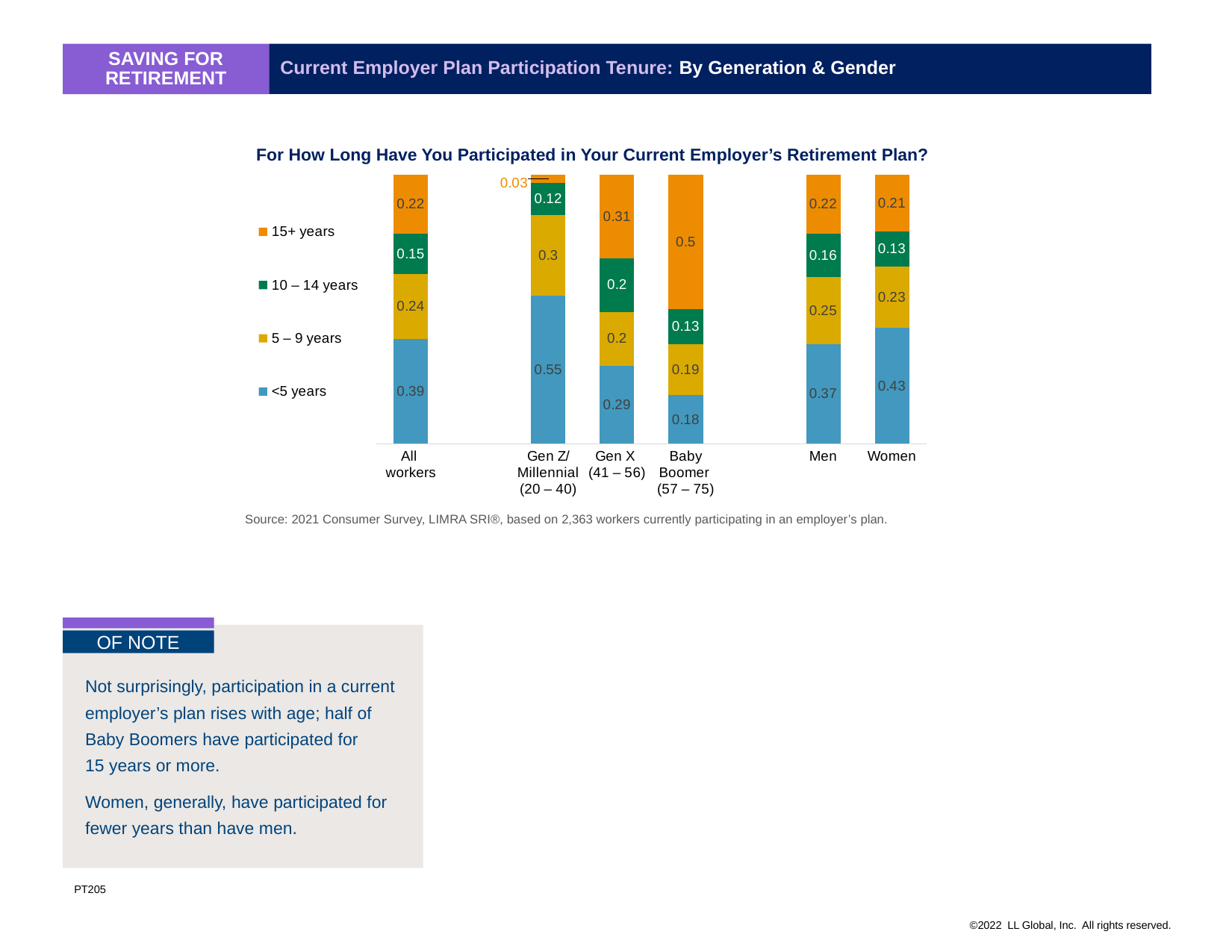
How many categories are plotted along the x axis? 6 What is the value for 15+ years for Baby Boomer (57 – 75)? 0.5 What kind of chart is shown on the slide? Stacked bar chart What is the difference between the <5 years values for Women and Men? 0.06 What is the value for 10 – 14 years for Men? 0.16 Which is larger, the 15+ years value for Gen X (41 – 56) or for All workers? Gen X (41 – 56) Which category has the highest value for 15+ years? Baby Boomer (57 – 75) Which category has the lowest value for <5 years? Baby Boomer (57 – 75) How many series does the legend list? 4 What is the value for 5 – 9 years for All workers? 0.24 What is the total of the stacked bar for Gen X (41 – 56)? 1 What is the value for <5 years for Gen Z/Millennial (20 – 40)? 0.55